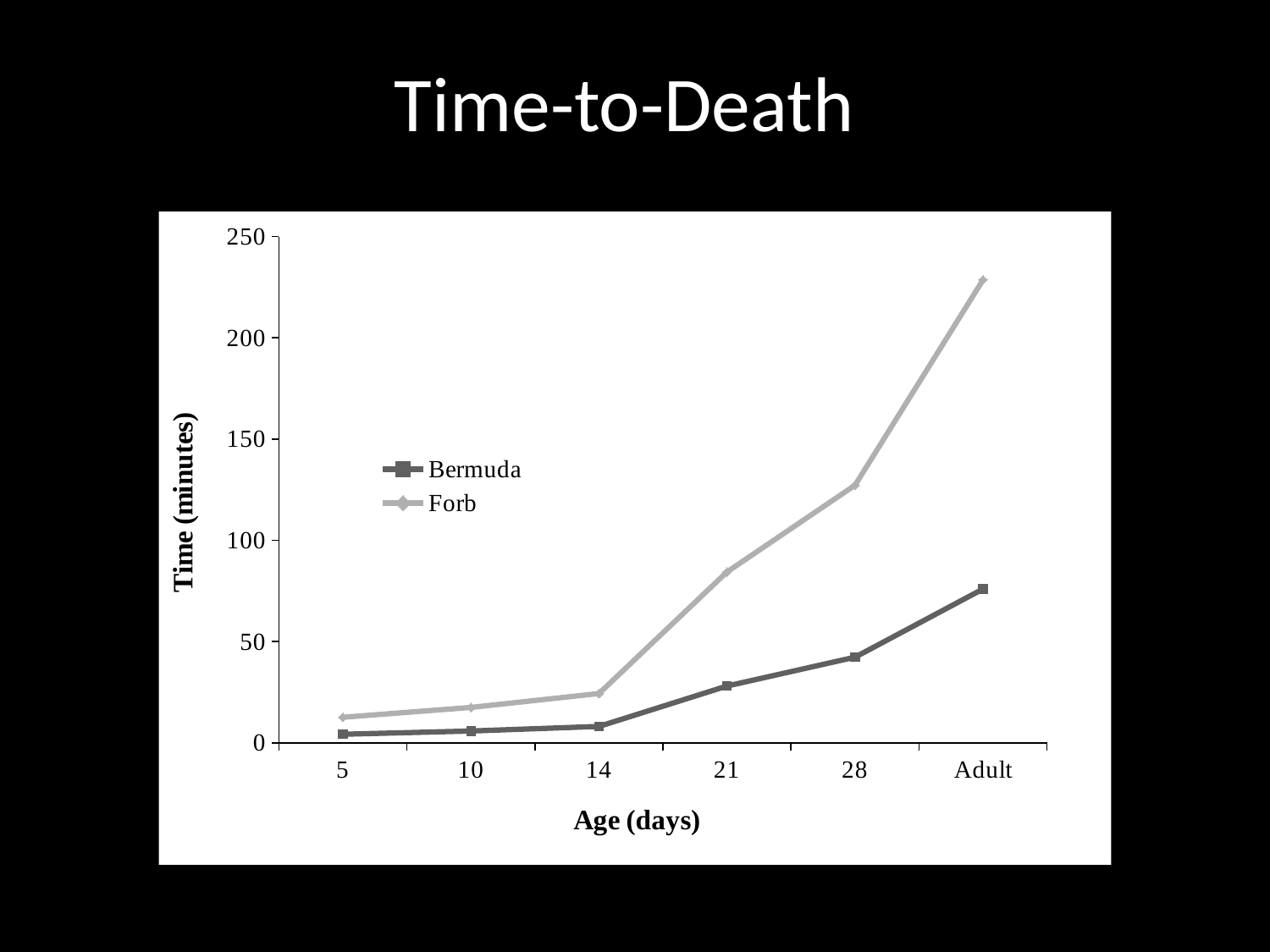
Do the Bermuda values rise or fall as age increases along the x axis? rise Which series has the larger value at Adult, Bermuda or Forb? Forb What is the label of the y axis? Time (minutes) Is the Bermuda value at 28 days greater or less than 50? less What kind of chart is shown on the slide? line chart How many series does the legend list? 2 Is the Forb value at 28 days greater or less than 100? greater At which age is the Forb time-to-death highest? Adult Is the Forb value at 21 days greater or less than 100? less How many age categories are shown on the x axis? 6